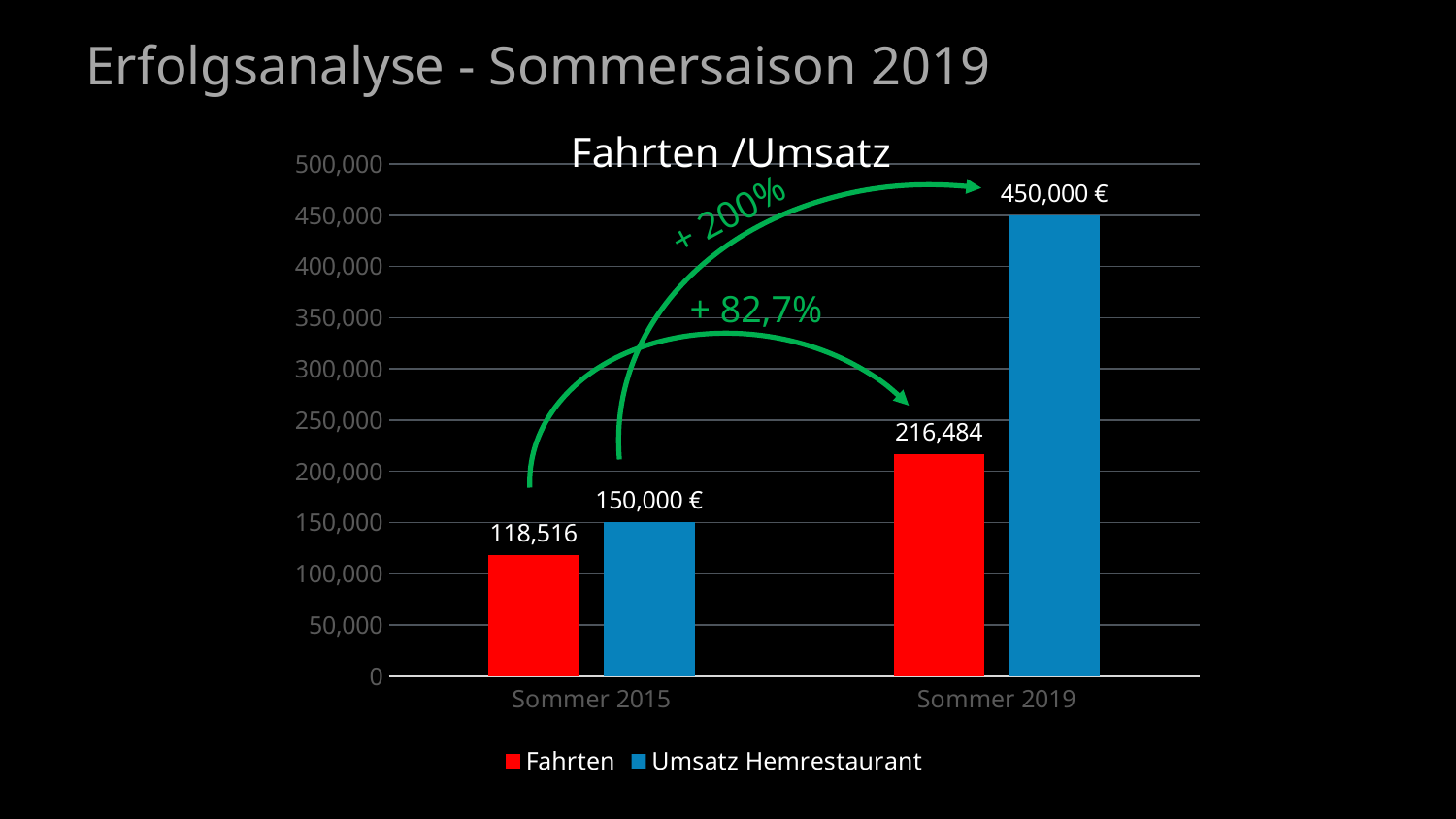
What is the value of Fahrten for Sommer 2019? 216,484 What is the difference in Fahrten between Sommer 2019 and Sommer 2015? 97,968 What is the difference in Umsatz Hemrestaurant between Sommer 2019 and Sommer 2015? 300,000 € What kind of chart is shown on the slide? Bar chart What is the title of the chart? Fahrten /Umsatz What is the value of Fahrten for Sommer 2015? 118,516 How many series does the legend list? 2 Which is larger: Fahrten for Sommer 2019 or Umsatz Hemrestaurant for Sommer 2015? Fahrten for Sommer 2019 What is the value of Umsatz Hemrestaurant for Sommer 2015? 150,000 € What is the value of Umsatz Hemrestaurant for Sommer 2019? 450,000 € Which category has the highest Umsatz Hemrestaurant value? Sommer 2019 Which category has the lowest Fahrten value? Sommer 2015